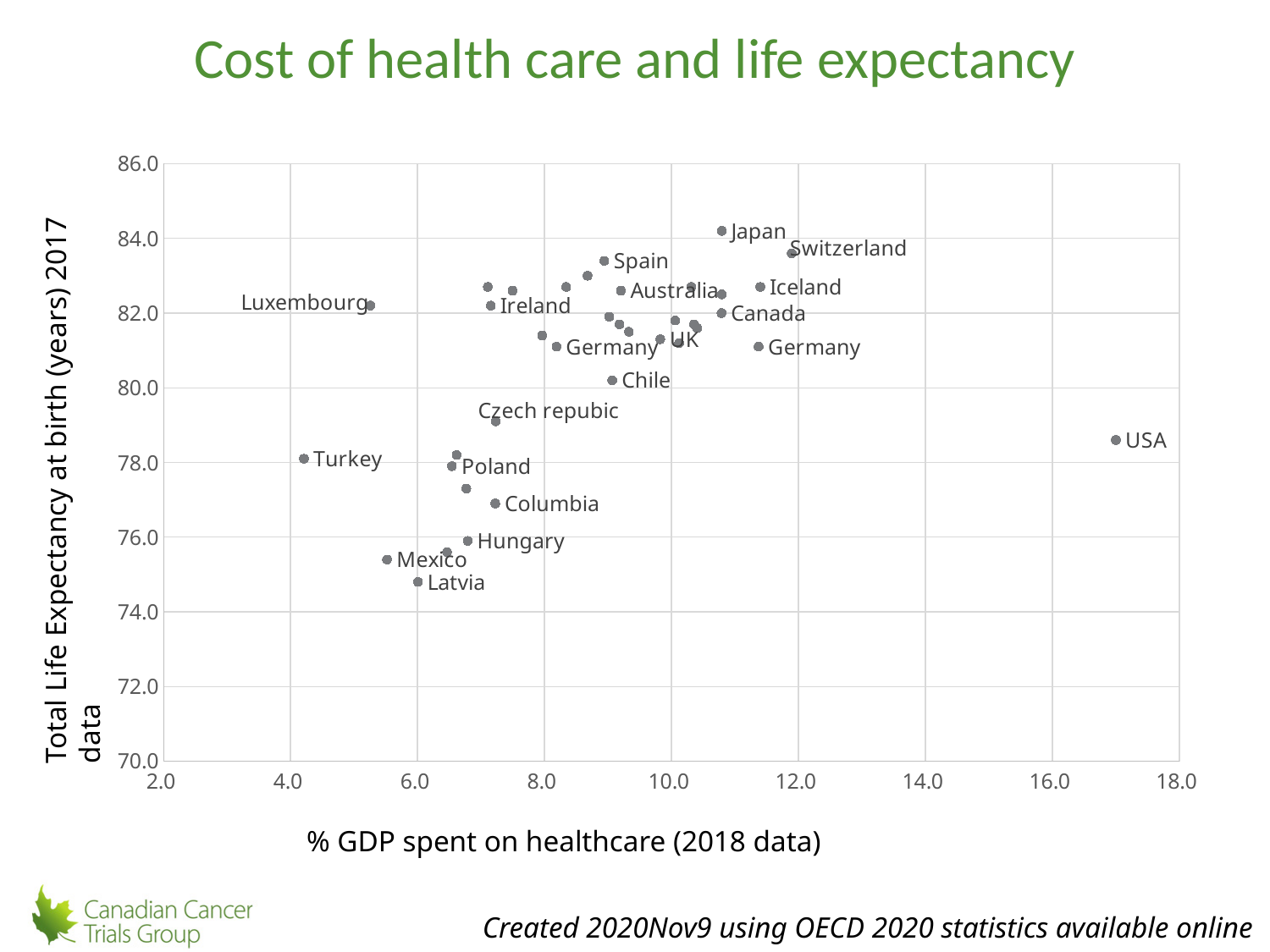
Which labelled country spends the lowest % of GDP on healthcare? Turkey What is the label of the horizontal axis? % GDP spent on healthcare (2018 data) Which has the higher life expectancy at birth, Japan or USA? Japan What kind of chart is shown on the slide? scatter chart Which labelled country has the lowest life expectancy at birth? Latvia What is the title of the chart? Cost of health care and life expectancy Which labelled country spends the highest % of GDP on healthcare? USA Is the % GDP spent on healthcare for USA greater or less than 16.0? greater Is the life expectancy value for USA greater or less than 80.0? less Is the life expectancy value for Chile greater or less than 82.0? less Which spends a larger % of GDP on healthcare, Turkey or Switzerland? Switzerland Which labelled country has the highest life expectancy at birth? Japan